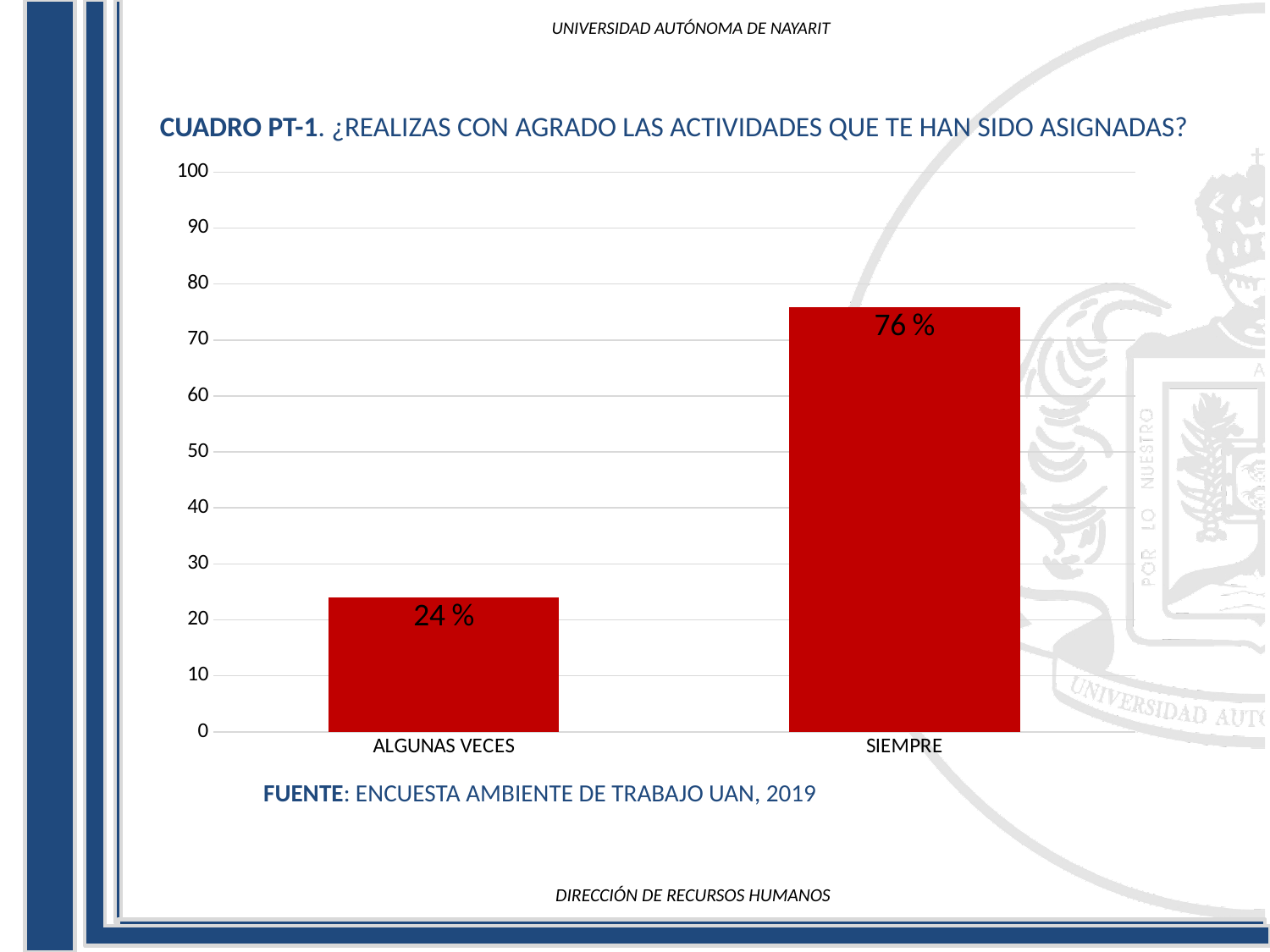
Which is larger, the value for ALGUNAS VECES or the value for SIEMPRE? SIEMPRE What kind of chart is shown on the slide? bar chart How many categories are shown on the x axis? 2 Is the value for SIEMPRE greater or less than 70? greater Which category has the lowest value? ALGUNAS VECES What is the value for ALGUNAS VECES? 24 % What is the value for SIEMPRE? 76 % Which category has the highest value? SIEMPRE What is the maximum value shown on the y axis? 100 Is the value for ALGUNAS VECES greater or less than 30? less What is the difference between the values for SIEMPRE and ALGUNAS VECES? 52 % What source is cited below the chart? ENCUESTA AMBIENTE DE TRABAJO UAN, 2019